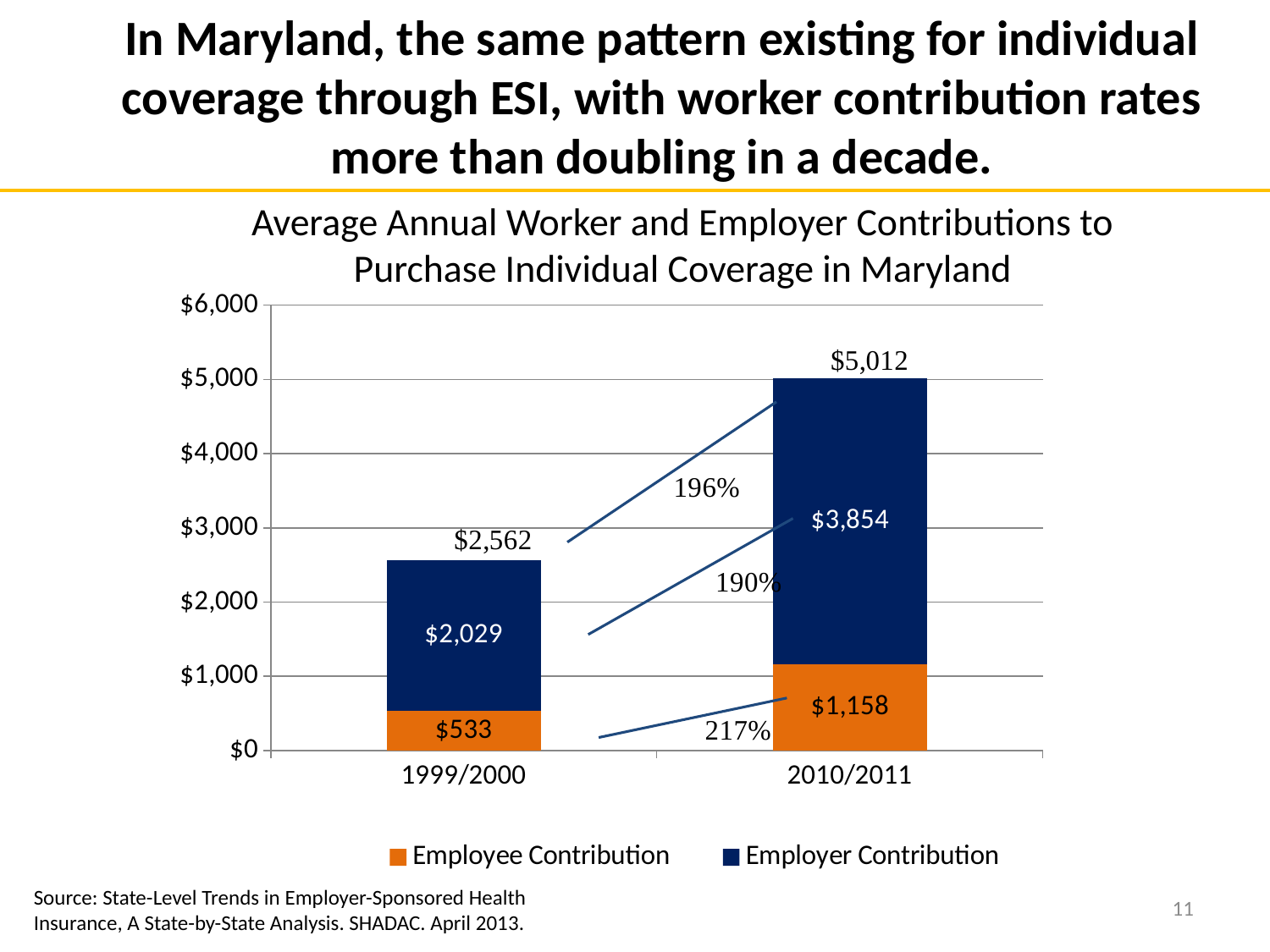
Which period has the higher Employer Contribution, 1999/2000 or 2010/2011? 2010/2011 How many series does the legend list? 2 What percentage change is labelled for the Employee Contribution between the two periods? 217% What is the Employer Contribution for 1999/2000? $2,029 What is the total of the stacked bar for 1999/2000? $2,562 What is the Employee Contribution for 2010/2011? $1,158 What is the difference between the Employee Contribution in 2010/2011 and in 1999/2000? $625 What kind of chart is shown on the slide? Stacked bar chart What is the Employee Contribution for 1999/2000? $533 What is the Employer Contribution for 2010/2011? $3,854 What is the total of the stacked bar for 2010/2011? $5,012 How many categories are shown on the x axis? 2